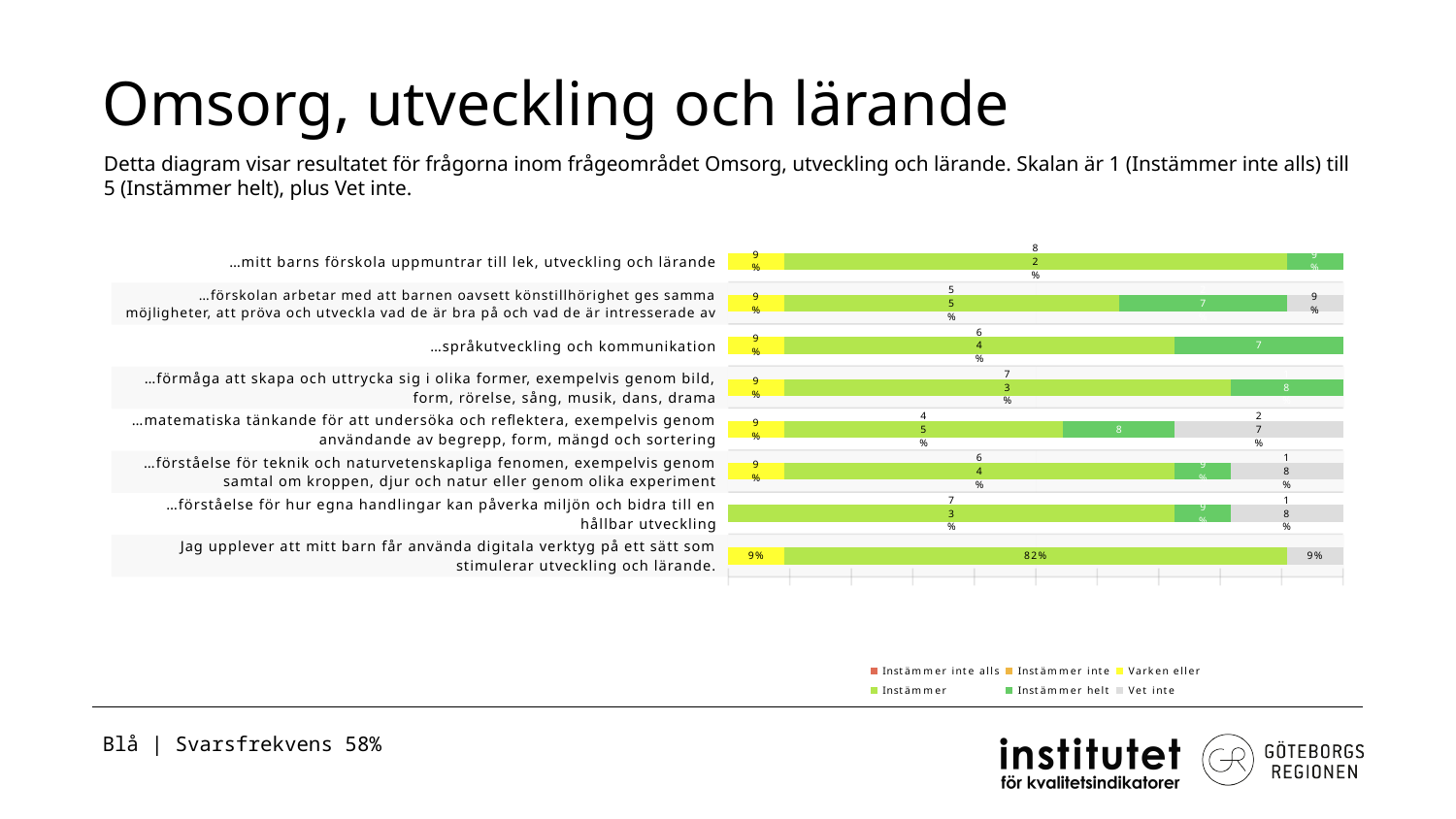
What is the title of the slide containing the chart? Omsorg, utveckling och lärande What is the 'Instämmer' value for 'Jag upplever att mitt barn får använda digitala verktyg på ett sätt som stimulerar utveckling och lärande.'? 82% Which question has the lowest 'Instämmer' share? …matematiska tänkande för att undersöka och reflektera, exempelvis genom användande av begrepp, form, mängd och sortering What is the 'Vet inte' value for 'Jag upplever att mitt barn får använda digitala verktyg på ett sätt som stimulerar utveckling och lärande.'? 9% What is the 'Instämmer' value for '…matematiska tänkande för att undersöka och reflektera, exempelvis genom användande av begrepp, form, mängd och sortering'? 45% How many series does the chart legend list? 6 What kind of chart is shown on the slide? Stacked bar chart How many questions (categories) are plotted in the chart? 8 What is the 'Vet inte' value for '…matematiska tänkande för att undersöka och reflektera, exempelvis genom användande av begrepp, form, mängd och sortering'? 27% Which has the larger 'Instämmer' share: '…språkutveckling och kommunikation' or '…matematiska tänkande för att undersöka och reflektera…'? …språkutveckling och kommunikation For 'Jag upplever att mitt barn får använda digitala verktyg…', what is the difference between the 'Instämmer' value and the 'Vet inte' value? 73 percentage points What is the 'Instämmer' value for '…förståelse för hur egna handlingar kan påverka miljön och bidra till en hållbar utveckling'? 73%